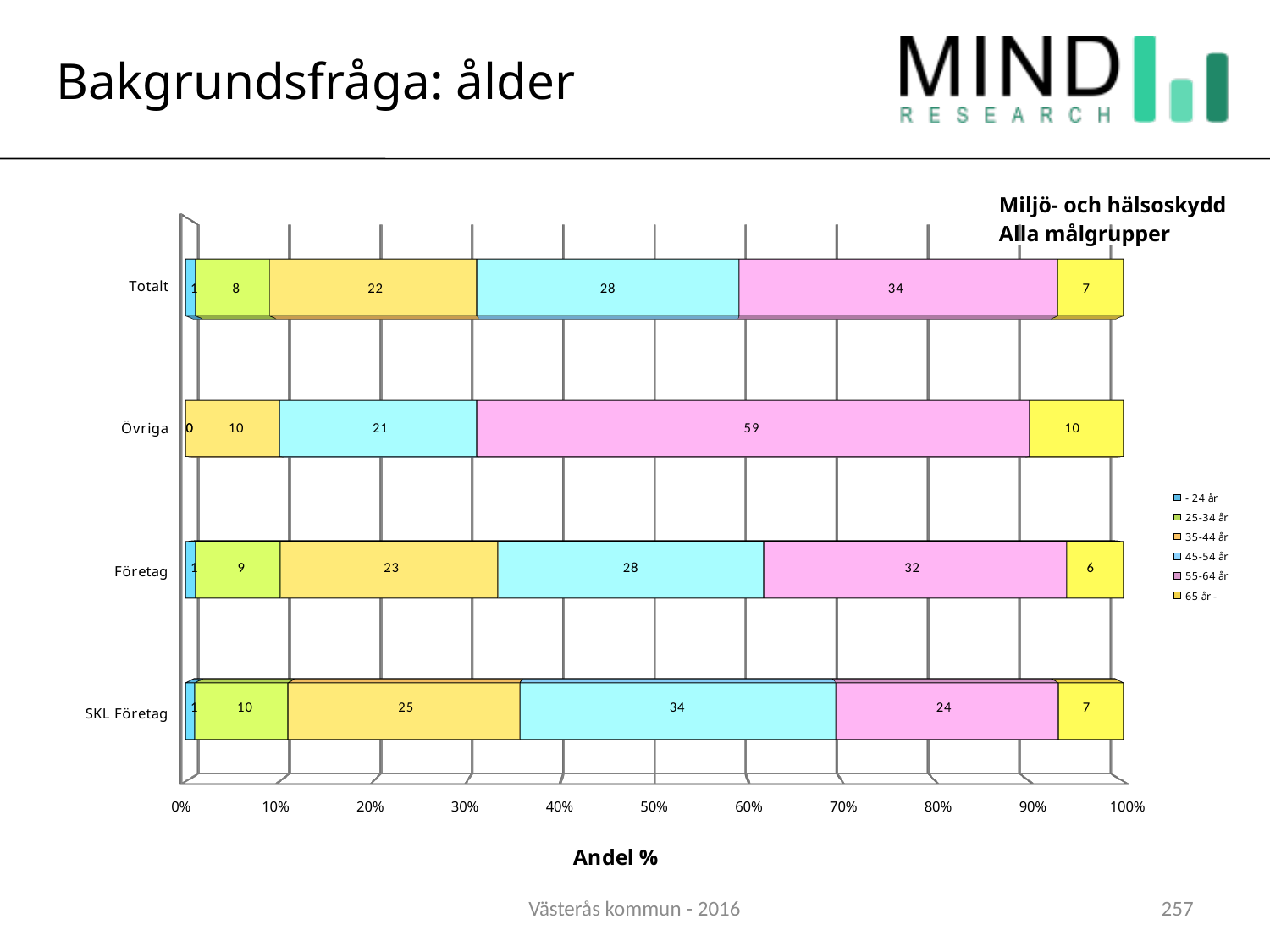
What is the difference between the 55-64 år values for Övriga and Totalt? 25 What is the value for 65 år - in the Företag category? 6 What is the value for 45-54 år in the SKL Företag category? 34 Which is larger: the 45-54 år value for SKL Företag or for Företag? SKL Företag What is the value for 55-64 år in the Övriga category? 59 What is the label of the x axis? Andel % Which category has the highest value for 55-64 år? Övriga What kind of chart is shown on the slide? Stacked bar chart Which category has the lowest value for 45-54 år? Övriga What is the value for 35-44 år in the Totalt category? 22 How many categories are shown on the y axis? 4 How many series does the legend list? 6